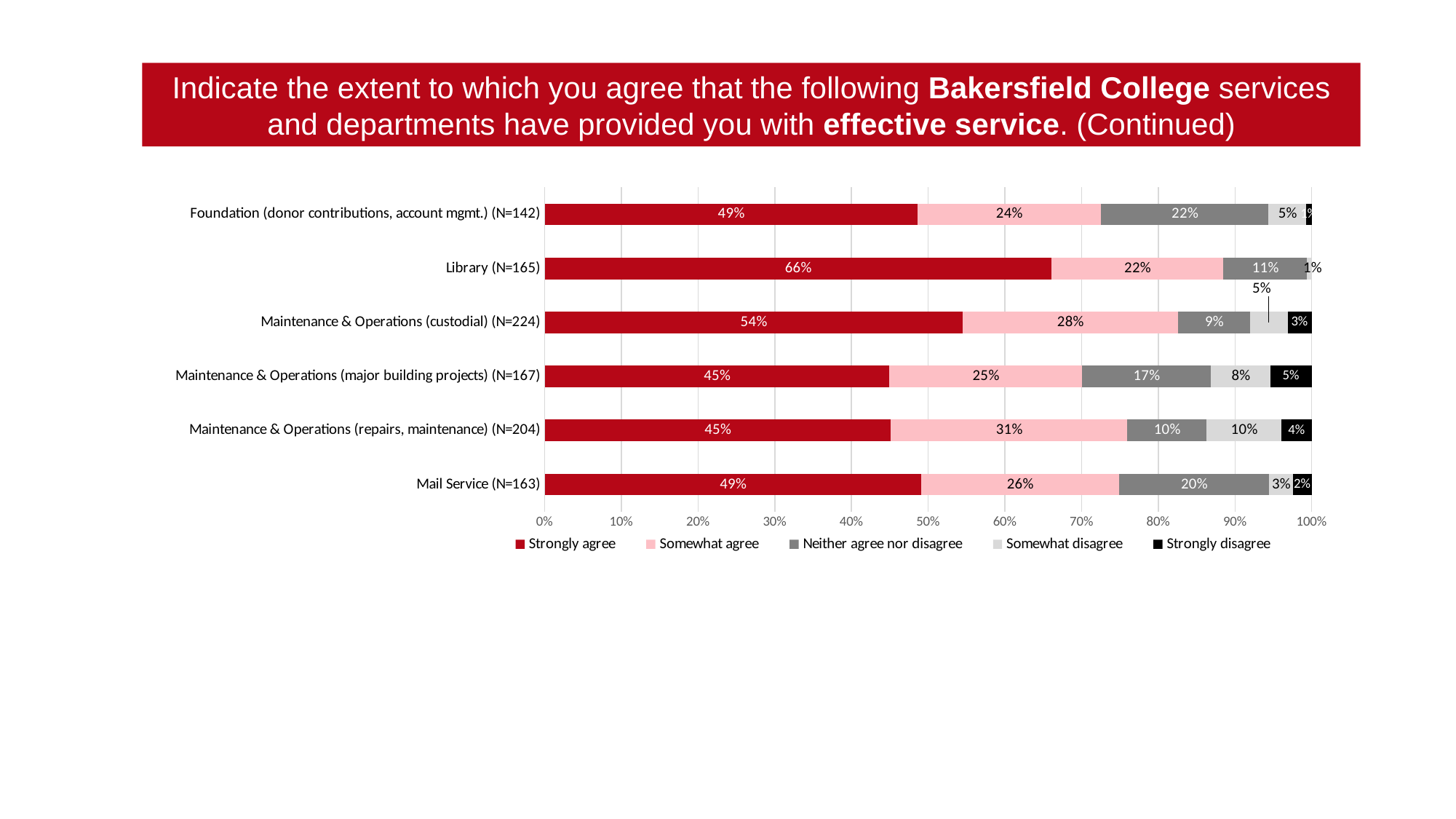
How many response categories does the legend list? 5 What kind of chart is shown on the slide? Bar chart What is the 'Somewhat disagree' percentage for Mail Service (N=163)? 3% Which has a larger 'Neither agree nor disagree' share: Foundation (N=142) or Mail Service (N=163)? Foundation (N=142) What is the difference in 'Strongly agree' percentage between Maintenance & Operations (custodial) and Maintenance & Operations (major building projects)? 9 percentage points What is the 'Strongly disagree' percentage for Maintenance & Operations (major building projects) (N=167)? 5% How many services or departments are listed on the chart? 6 Which service has the highest 'Somewhat agree' percentage? Maintenance & Operations (repairs, maintenance) (N=204) What is the first entry in the chart's legend? Strongly agree What percentage of respondents strongly agree that the Library (N=165) provided effective service? 66% What is the 'Somewhat agree' percentage for Maintenance & Operations (repairs, maintenance) (N=204)? 31% Which service has the highest 'Strongly agree' percentage? Library (N=165)